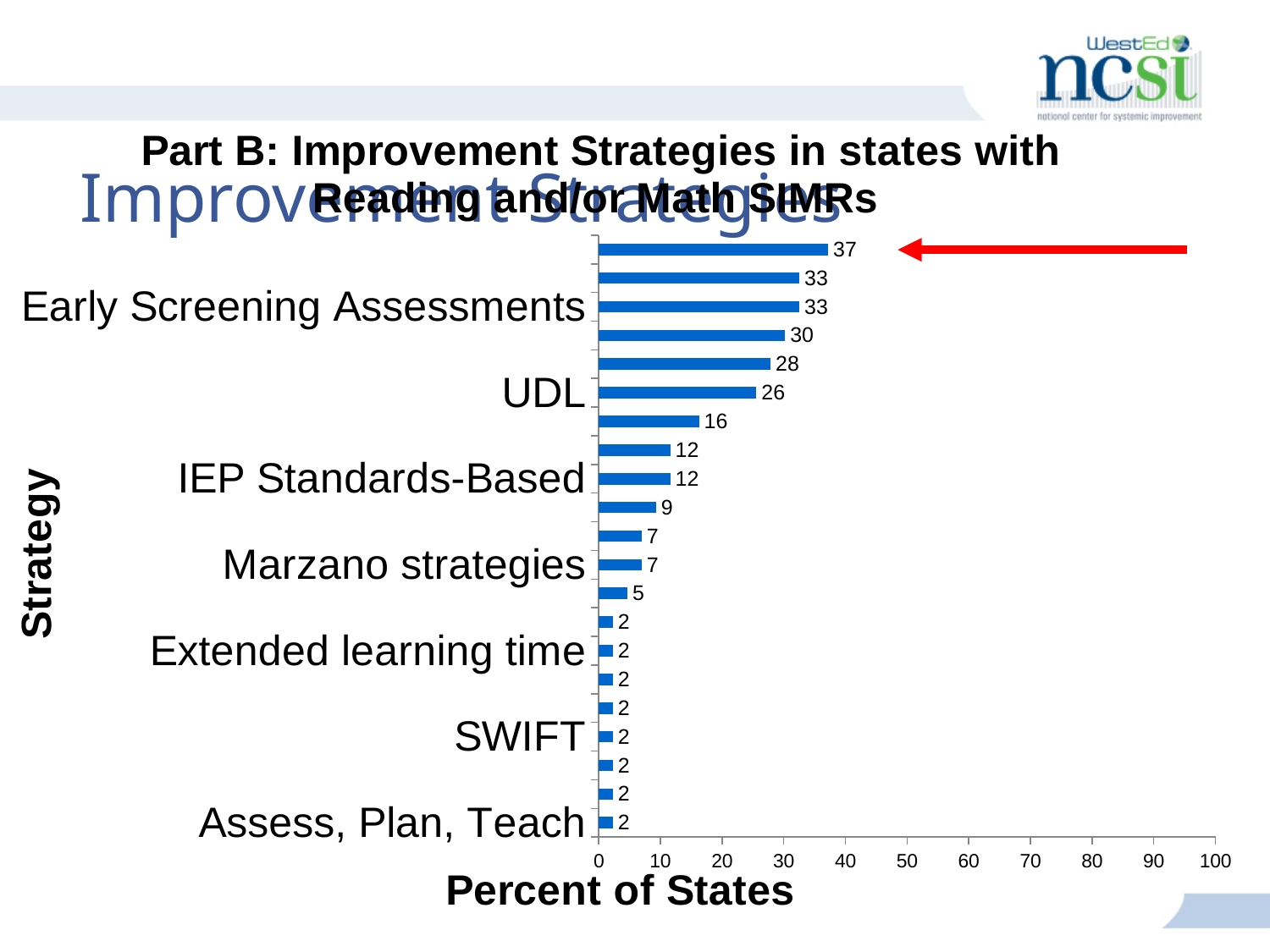
Which has a larger value, UDL or IEP Standards-Based? UDL What is the difference between the values for Early Screening Assessments and UDL? 7 What is the value for SWIFT? 2 What type of chart is shown on the slide? bar chart What is the value for Marzano strategies? 7 What is the label of the vertical axis? Strategy How many bars are plotted on the chart? 21 What is the highest value shown on the chart? 37 What is the value for UDL? 26 What is the value for IEP Standards-Based? 12 What is the label of the horizontal axis? Percent of States What is the value for Early Screening Assessments? 33